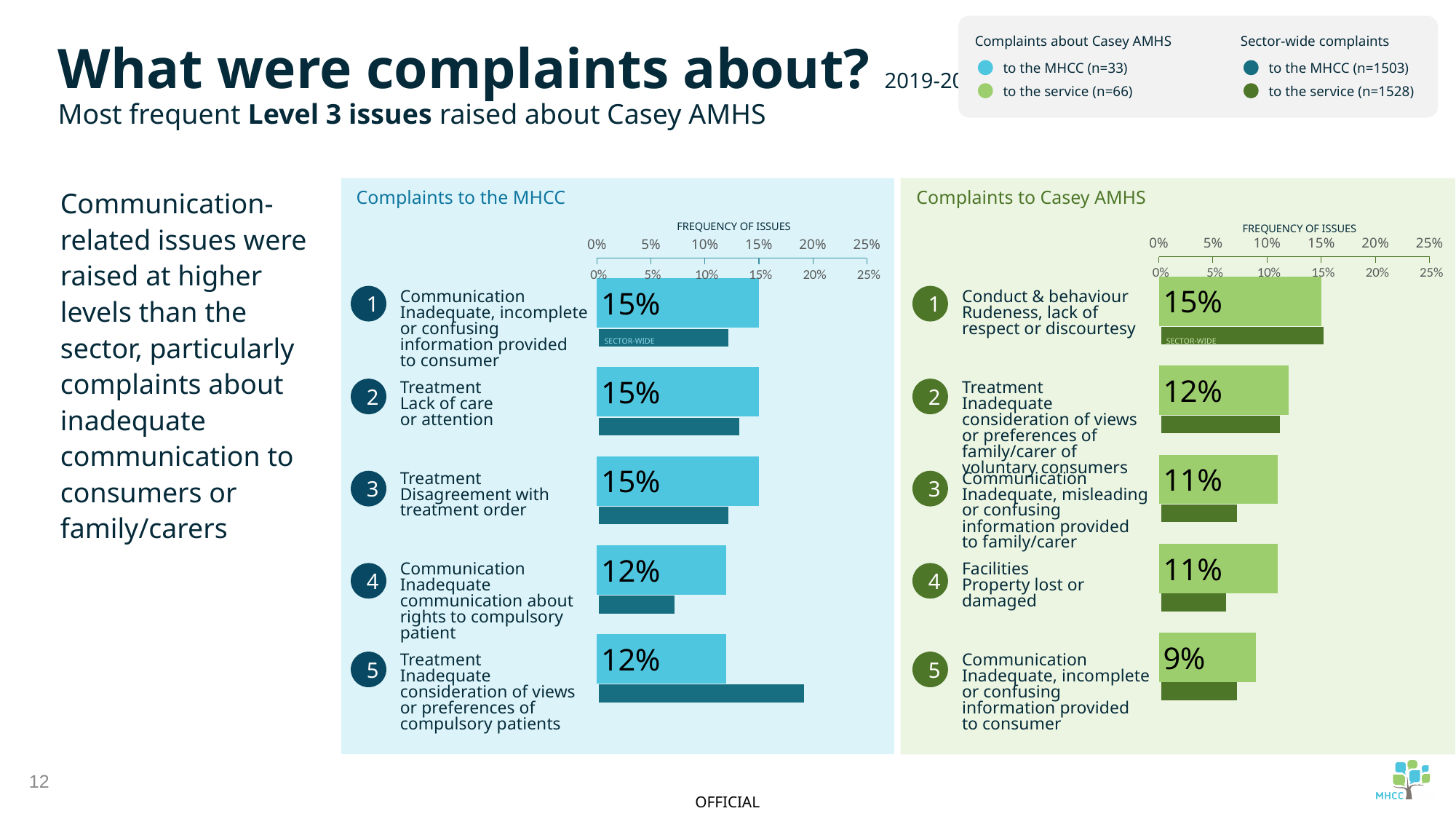
In the 'Complaints to the MHCC' chart, is the sector-wide value for issue 5 (Treatment – inadequate consideration of views of compulsory patients) greater or less than 15%? greater In the 'Complaints to Casey AMHS' chart, what is the frequency for issue 1, Conduct & behaviour – rudeness, lack of respect or discourtesy? 15% In the 'Complaints to the MHCC' chart, what is the difference between the frequency for issue 2 (Treatment – lack of care or attention) and issue 5 (Treatment – inadequate consideration of views of compulsory patients)? 3% In the 'Complaints to Casey AMHS' chart, which issue has the lowest frequency? Communication – inadequate, incomplete or confusing information provided to consumer In the 'Complaints to Casey AMHS' chart, what is the frequency for issue 5, Communication – inadequate, incomplete or confusing information provided to consumer? 9% In the 'Complaints to the MHCC' chart, what is the frequency for issue 4, Communication – inadequate communication about rights to compulsory patient? 12% What kind of chart is the 'Complaints to the MHCC' chart? Bar chart In the 'Complaints to the MHCC' chart, what is the frequency for issue 1, Communication – inadequate, incomplete or confusing information provided to consumer? 15% How many issues are listed in the 'Complaints to Casey AMHS' chart? 5 In the 'Complaints to the MHCC' chart, is the sector-wide value for issue 4 (Communication about rights to compulsory patient) greater or less than 10%? less In the 'Complaints to Casey AMHS' chart, which issue has the highest frequency? Conduct & behaviour – rudeness, lack of respect or discourtesy In the 'Complaints to Casey AMHS' chart, what is the difference between the frequency for issue 1 (Conduct & behaviour) and issue 5 (Communication to consumer)? 6%